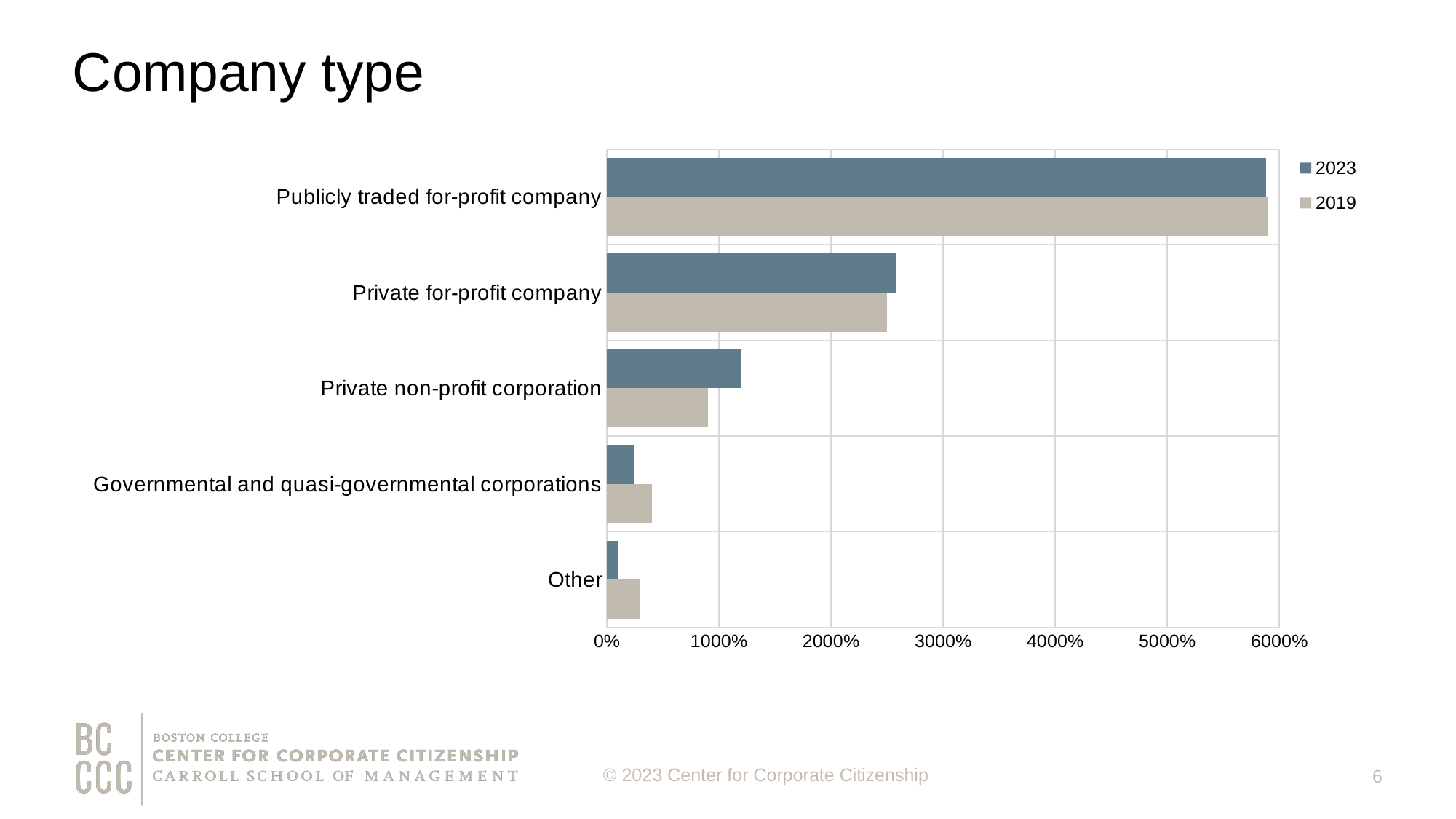
For Private non-profit corporation, which year has the larger value, 2023 or 2019? 2023 Is the 2019 value for Private non-profit corporation greater or less than 1000%? less Which company type has the lowest value for 2023? Other How many company type categories are plotted on the chart? 5 For Other, which year has the larger value, 2023 or 2019? 2019 Which series is shown in the darker blue-grey colour? 2023 How many series does the legend list? 2 For Governmental and quasi-governmental corporations, which year has the larger value, 2023 or 2019? 2019 Which company type has the lowest value for 2019? Other Which company type has the highest value for 2023? Publicly traded for-profit company What kind of chart is shown on the slide? bar chart Is the 2023 value for Private for-profit company greater or less than 2000%? greater